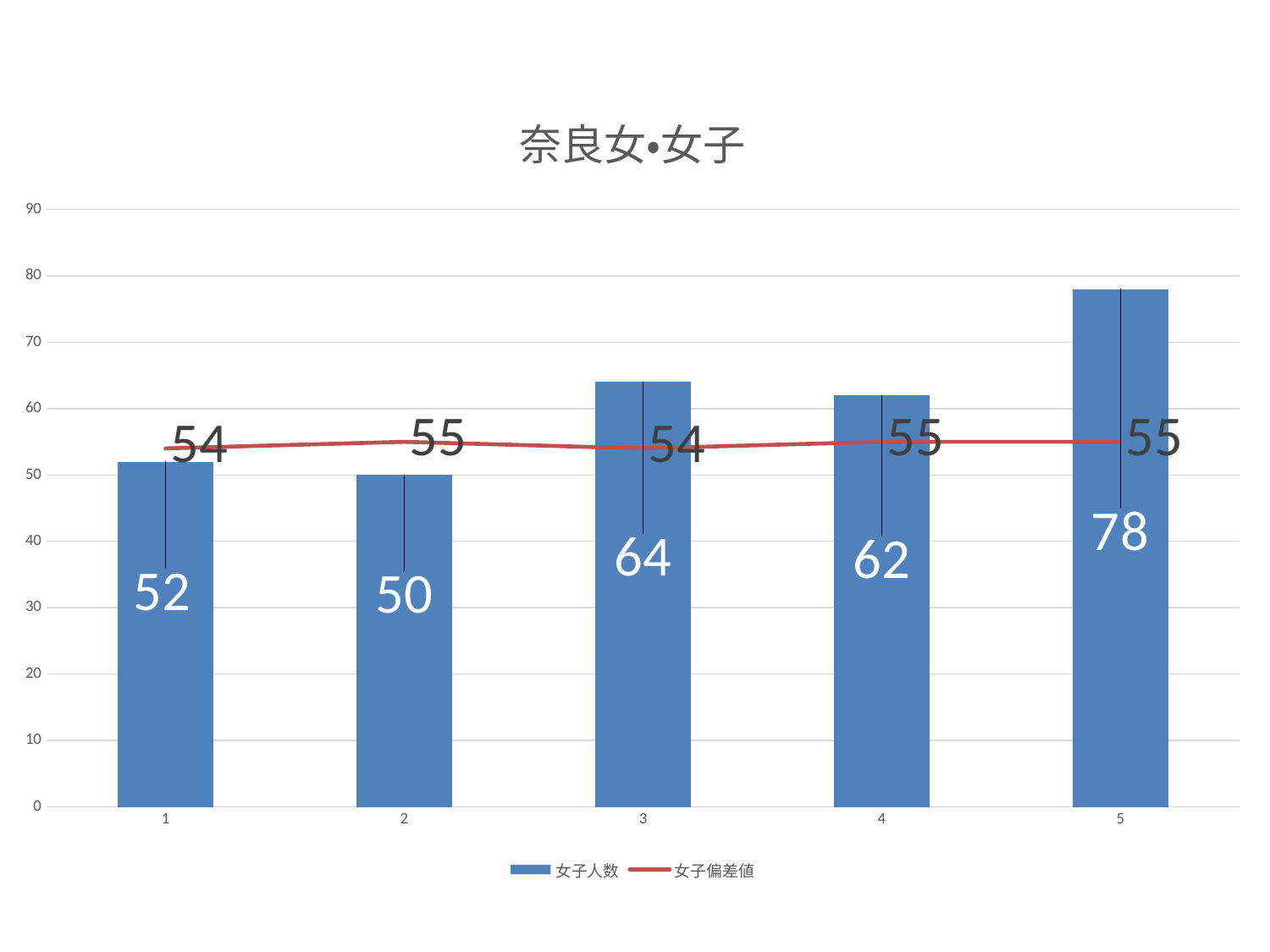
What is the value of 女子人数 for category 3? 64 What colour is the 女子偏差値 line? red Which is larger, the 女子人数 for category 3 or for category 4? category 3 What is the difference in 女子人数 between category 5 and category 1? 26 Which category has the lowest 女子人数? 2 What is the title of the chart? 奈良女•女子 What is the value of 女子偏差値 for category 2? 55 What kind of chart is used for the 女子人数 series? bar chart How many series does the legend list? 2 Is the 女子人数 for category 5 greater or less than 70? greater How many categories are shown on the x axis? 5 Which category has the highest 女子人数? 5